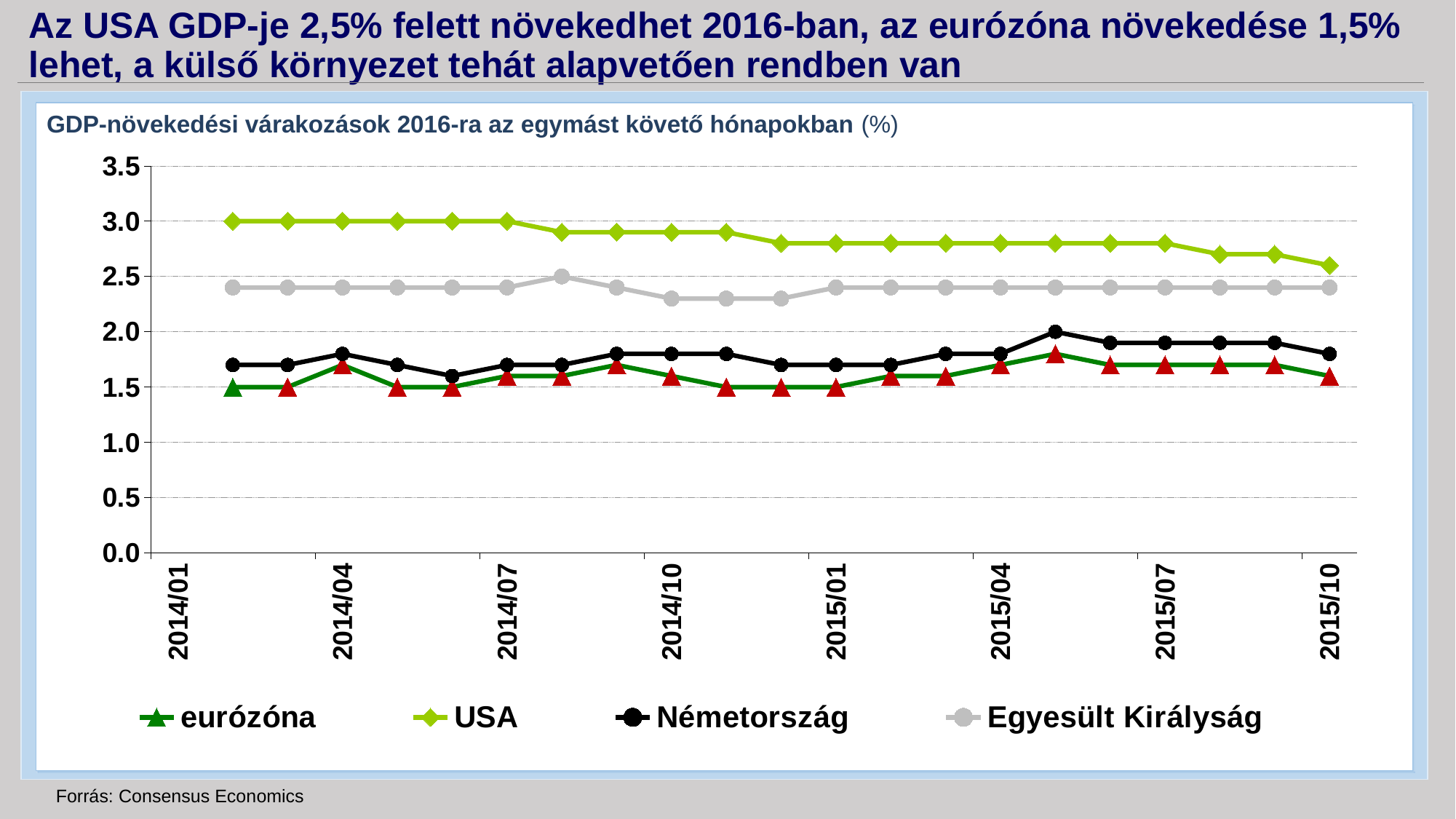
Which series has the highest value at 2015/10? USA What kind of chart is shown on the slide? line chart Is the eurózóna value at 2015/10 greater or less than 2.0? less What is the USA value at 2014/04? 3.0 What is the title of the chart? GDP-növekedési várakozások 2016-ra az egymást követő hónapokban (%) Does the USA series rise or fall from 2014/04 to 2015/10? fall What is the USA value at 2014/07? 3.0 Is the Egyesült Királyság value at 2015/10 greater or less than 2.5? less Which series has the lowest value at 2014/04? eurózóna How many series does the legend list? 4 Is the Németország value at 2015/10 greater or less than 2.0? less